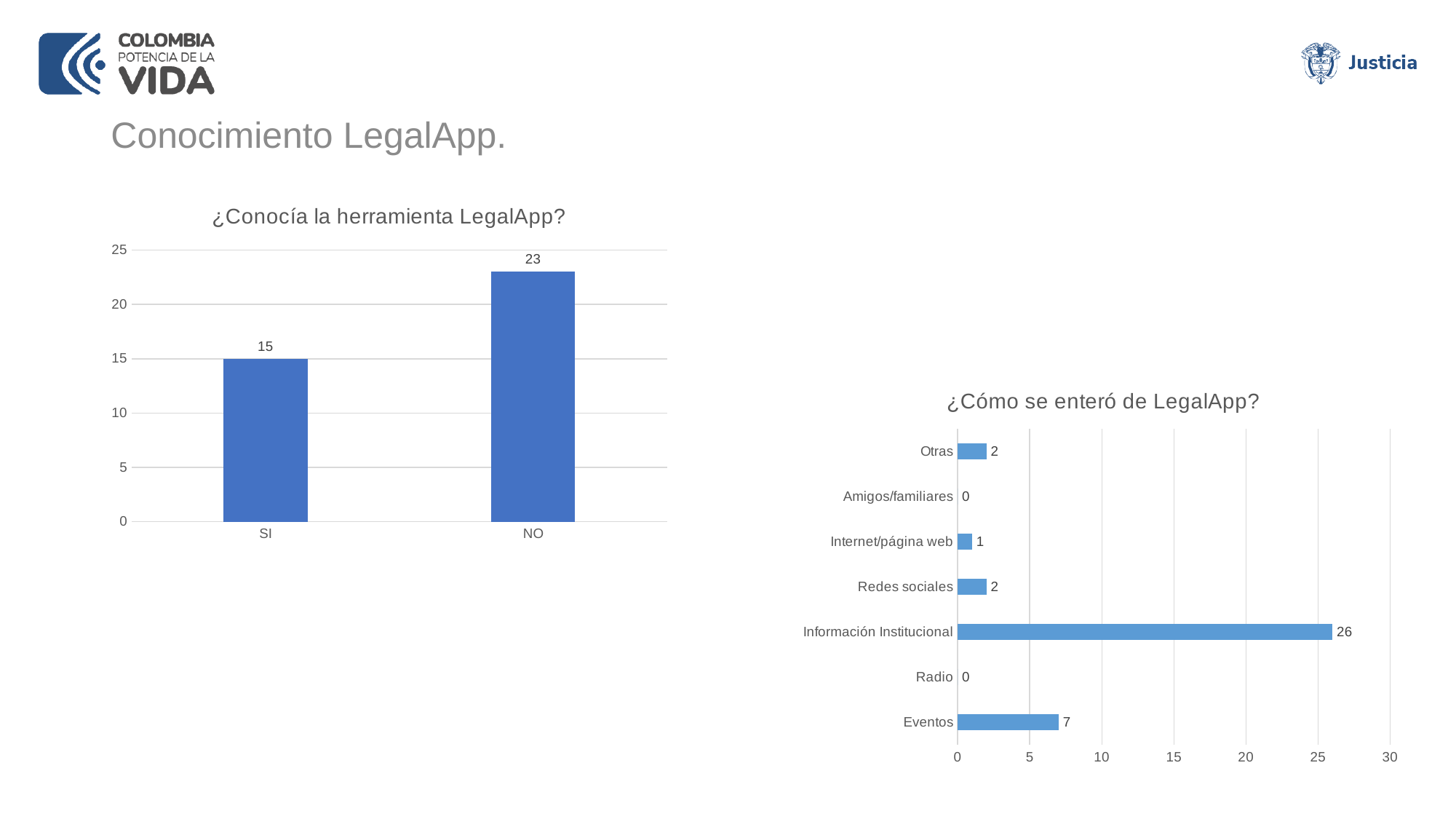
In the chart titled '¿Cómo se enteró de LegalApp?', what is the value for Eventos? 7 In the chart titled '¿Conocía la herramienta LegalApp?', what is the difference between NO and SI? 8 In the chart titled '¿Conocía la herramienta LegalApp?', which category has the higher value? NO In the chart titled '¿Cómo se enteró de LegalApp?', how many categories are listed? 7 In the chart titled '¿Cómo se enteró de LegalApp?', what is the difference between Información Institucional and Eventos? 19 In the chart titled '¿Conocía la herramienta LegalApp?', how many categories are shown? 2 In the chart titled '¿Cómo se enteró de LegalApp?', which is larger, Eventos or Redes sociales? Eventos In the chart titled '¿Conocía la herramienta LegalApp?', what is the value for SI? 15 In the chart titled '¿Cómo se enteró de LegalApp?', which category has the highest value? Información Institucional In the chart titled '¿Conocía la herramienta LegalApp?', what is the value for NO? 23 In the chart titled '¿Cómo se enteró de LegalApp?', what is the value for Información Institucional? 26 What kind of chart is the one titled '¿Cómo se enteró de LegalApp?'? Bar chart